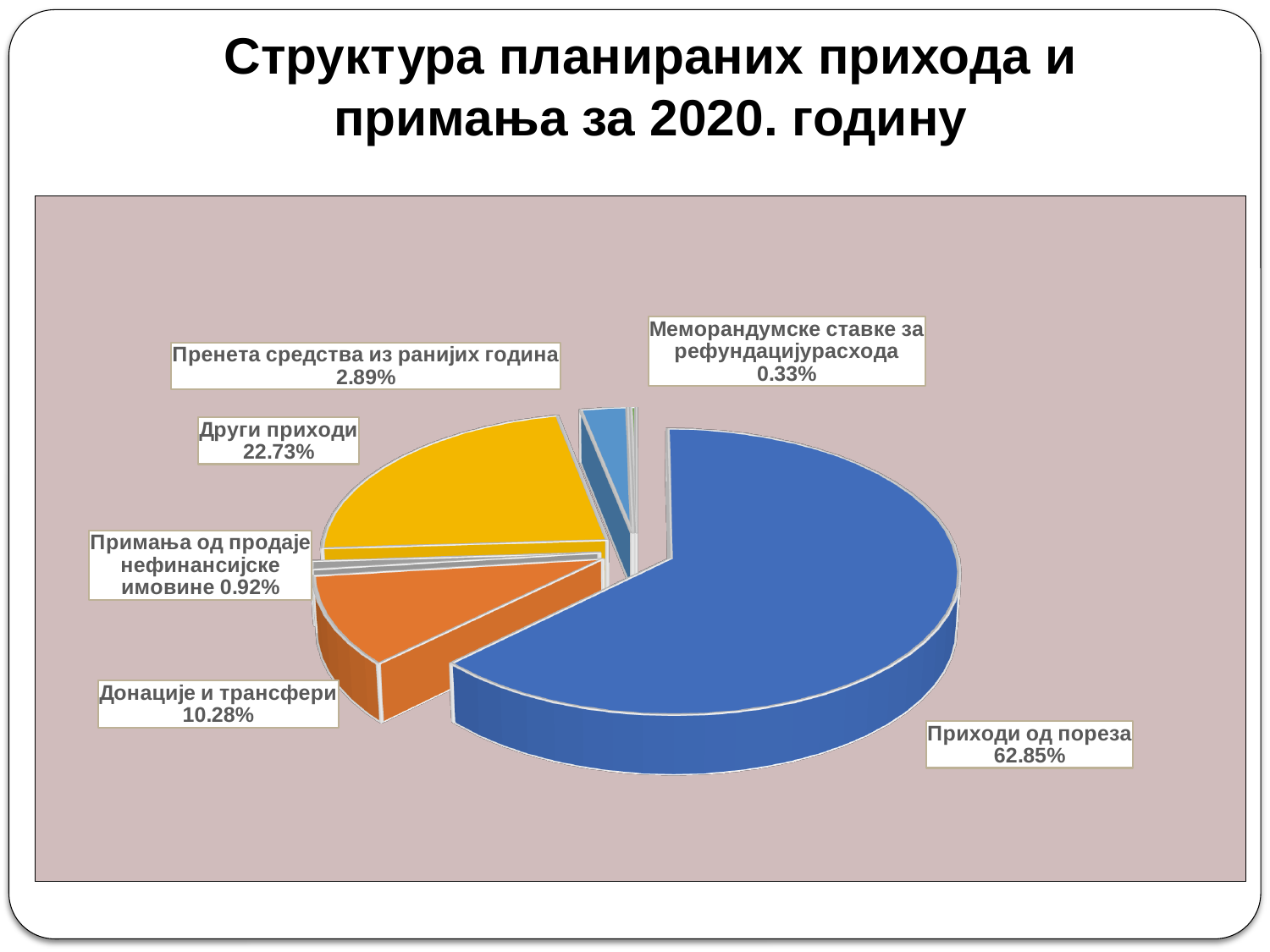
How many slices does the pie chart have? 6 What share of the pie does "Приходи од пореза" represent? 62.85% Which category has the smallest share of the pie? Меморандумске ставке за рефундацију расхода What is the title of the slide? Структура планираних прихода и примања за 2020. годину What is the value shown for "Пренета средства из ранијих година"? 2.89% What is the value shown for "Други приходи"? 22.73% What is the difference in percentage points between "Приходи од пореза" and "Други приходи"? 40.12 What is the value shown for "Примања од продаје нефинансијске имовине"? 0.92% What kind of chart is shown on the slide? Pie chart Which category has the largest share of the pie? Приходи од пореза What is the value shown for "Донације и трансфери"? 10.28% Which is larger, "Донације и трансфери" or "Други приходи"? Други приходи